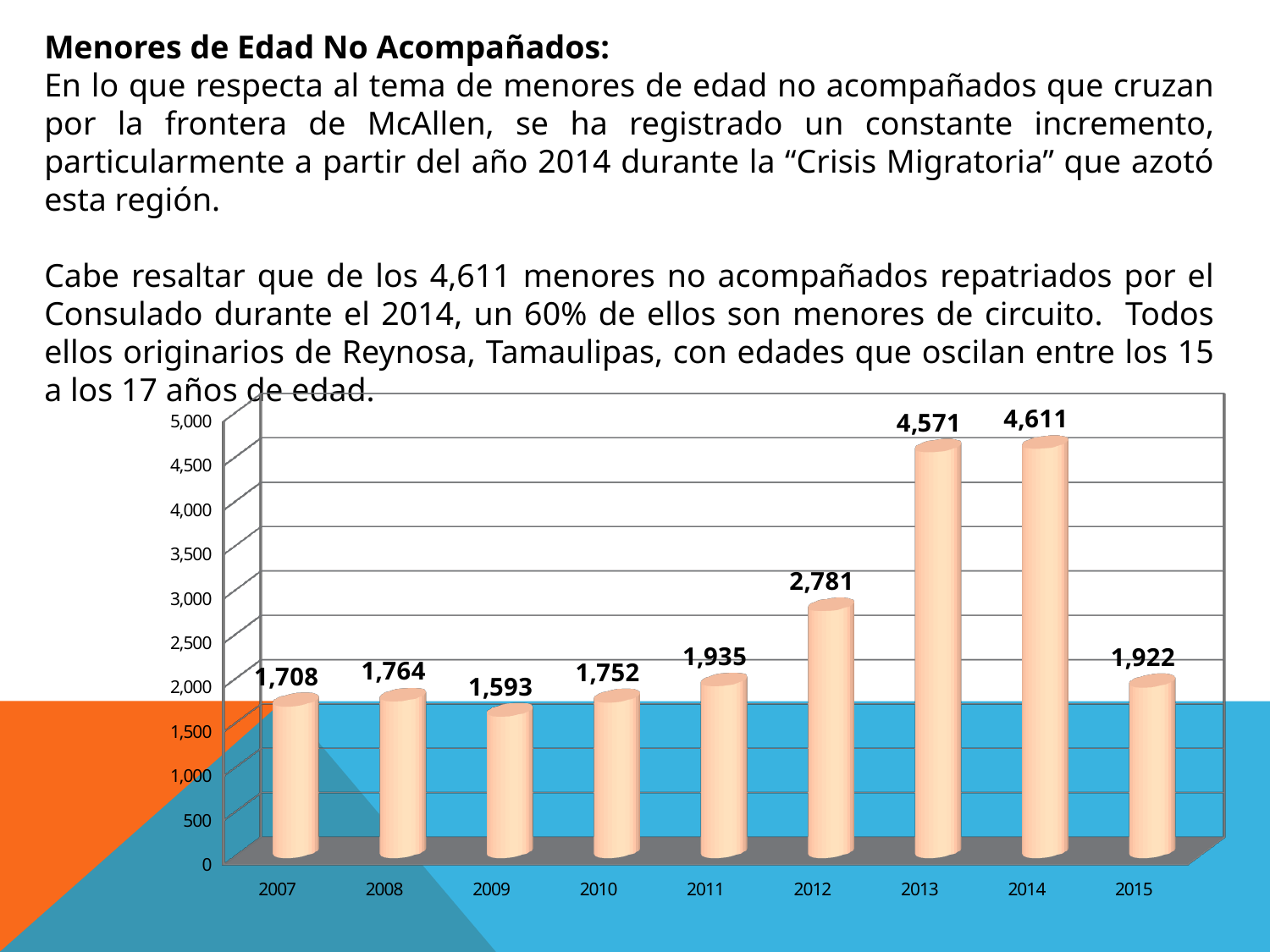
What is the value for 2014? 4,611 What is the difference between the values for 2013 and 2012? 1,790 What is the value for 2009? 1,593 Does the value rise or fall from 2014 to 2015? fall Is the value for 2012 greater or less than 2,500? greater Which year has the highest value? 2014 What is the difference between the values for 2014 and 2013? 40 Which year has the lowest value? 2009 Which is larger, the value for 2011 or the value for 2015? 2011 What is the value for 2012? 2,781 How many years are shown on the x axis? 9 What kind of chart is shown on the slide? bar chart